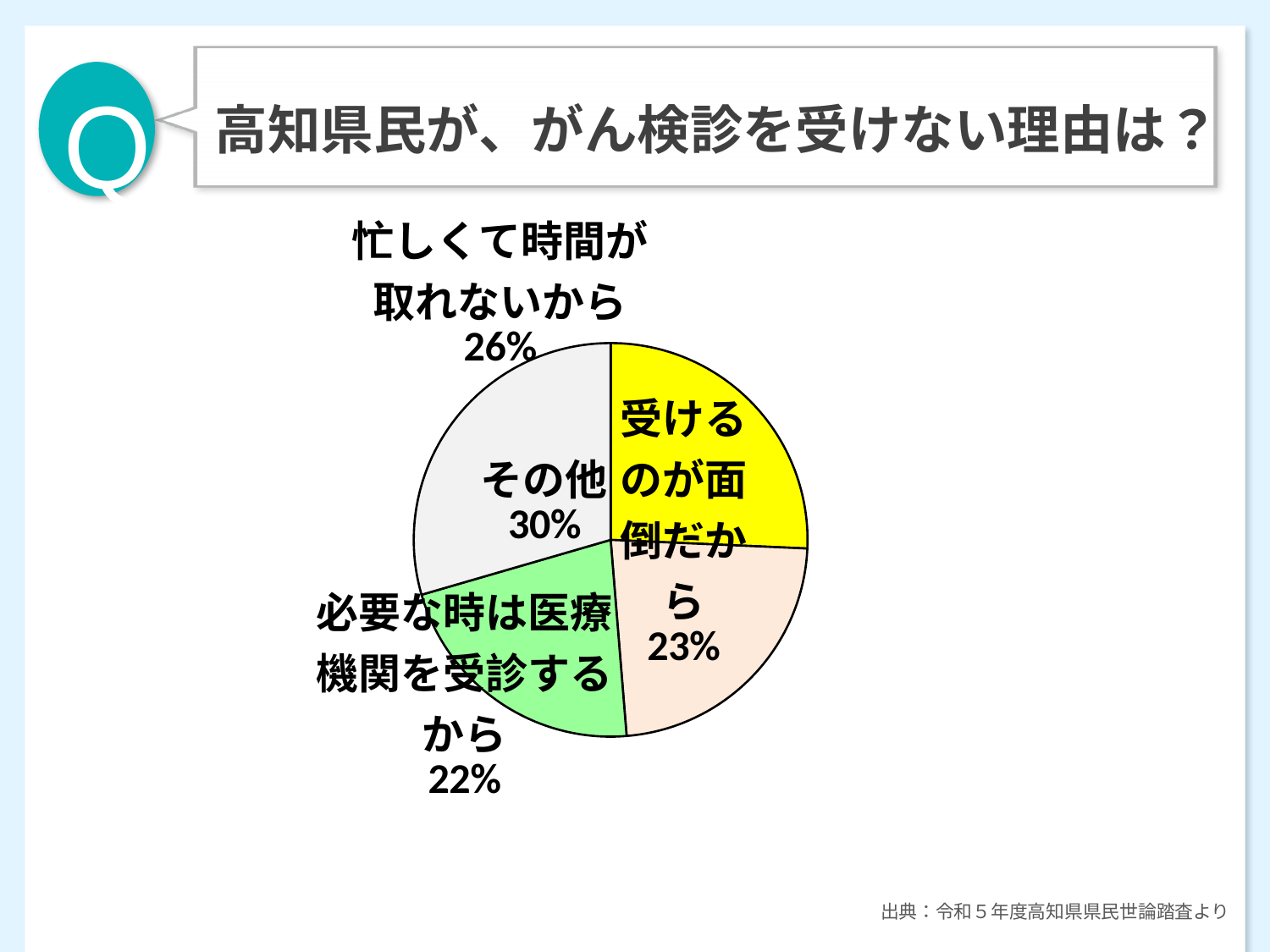
Which is larger, the share for 忙しくて時間が取れないから or the share for 受けるのが面倒だから? 忙しくて時間が取れないから What kind of chart is shown on the slide? pie chart What share of the pie is その他? 30% Which category has the largest share of the pie? その他 What percentage is shown for 受けるのが面倒だから? 23% Which category has the smallest share of the pie? 必要な時は医療機関を受診するから What is the question posed in the slide title? 高知県民が、がん検診を受けない理由は？ How many slices does the pie chart have? 4 What is the difference in percentage points between 忙しくて時間が取れないから and 受けるのが面倒だから? 3 What percentage is shown for 忙しくて時間が取れないから? 26% What percentage is shown for 必要な時は医療機関を受診するから? 22% What is the difference in percentage points between その他 and 必要な時は医療機関を受診するから? 8